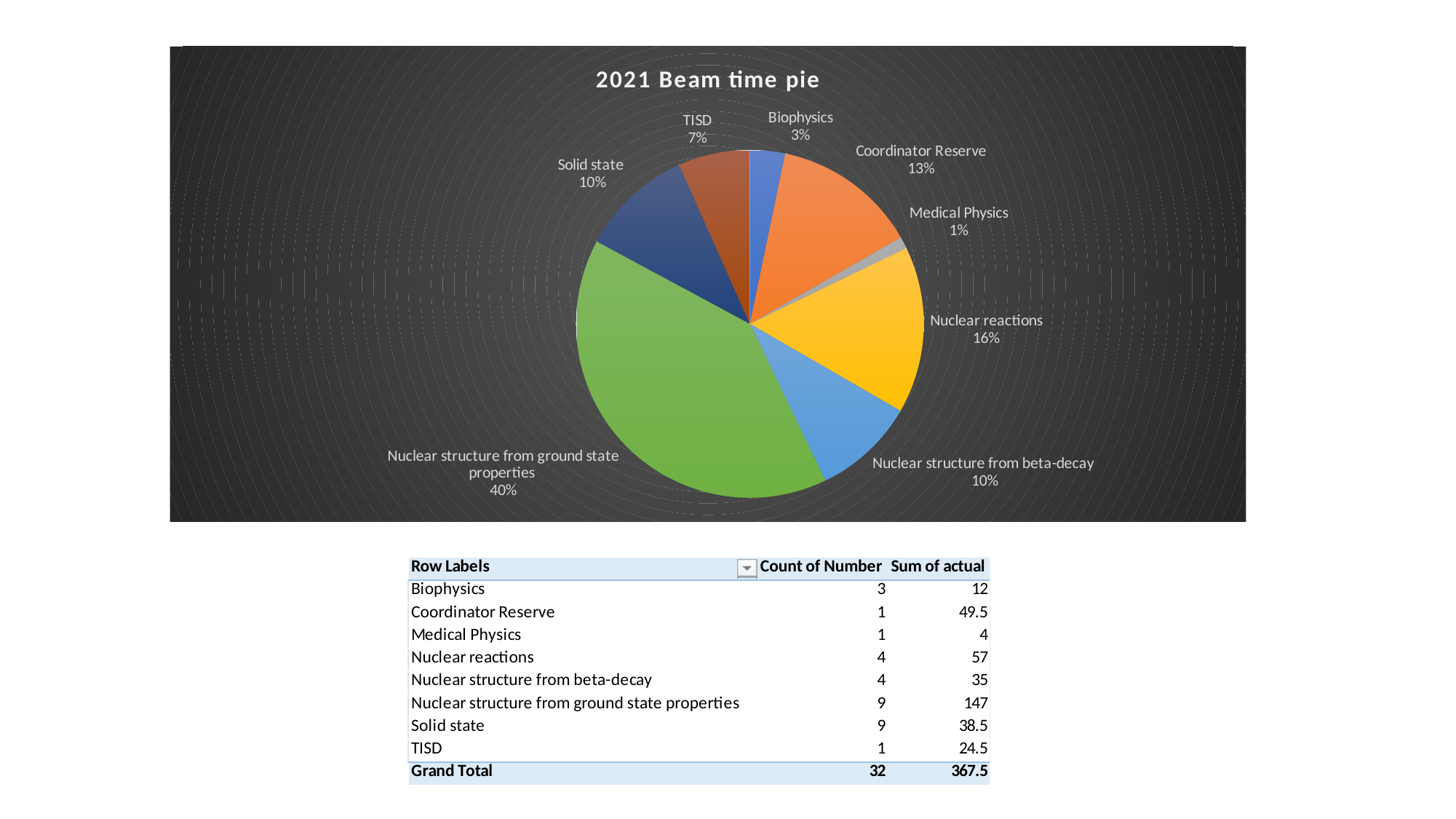
What percentage share does TISD have in the pie chart? 7% What type of chart is shown on the slide? pie chart What is the difference in percentage points between the Nuclear structure from ground state properties slice and the Nuclear reactions slice? 24 percentage points What percentage share does Coordinator Reserve have in the pie chart? 13% Which category has the smallest slice in the pie chart? Medical Physics Which has a larger share in the pie chart, Nuclear reactions or Coordinator Reserve? Nuclear reactions Which has a larger share in the pie chart, Biophysics or Solid state? Solid state Which category has the largest slice in the pie chart? Nuclear structure from ground state properties What percentage share does Nuclear reactions have in the pie chart? 16% How many categories are shown in the pie chart? 8 What is the title of the chart? 2021 Beam time pie